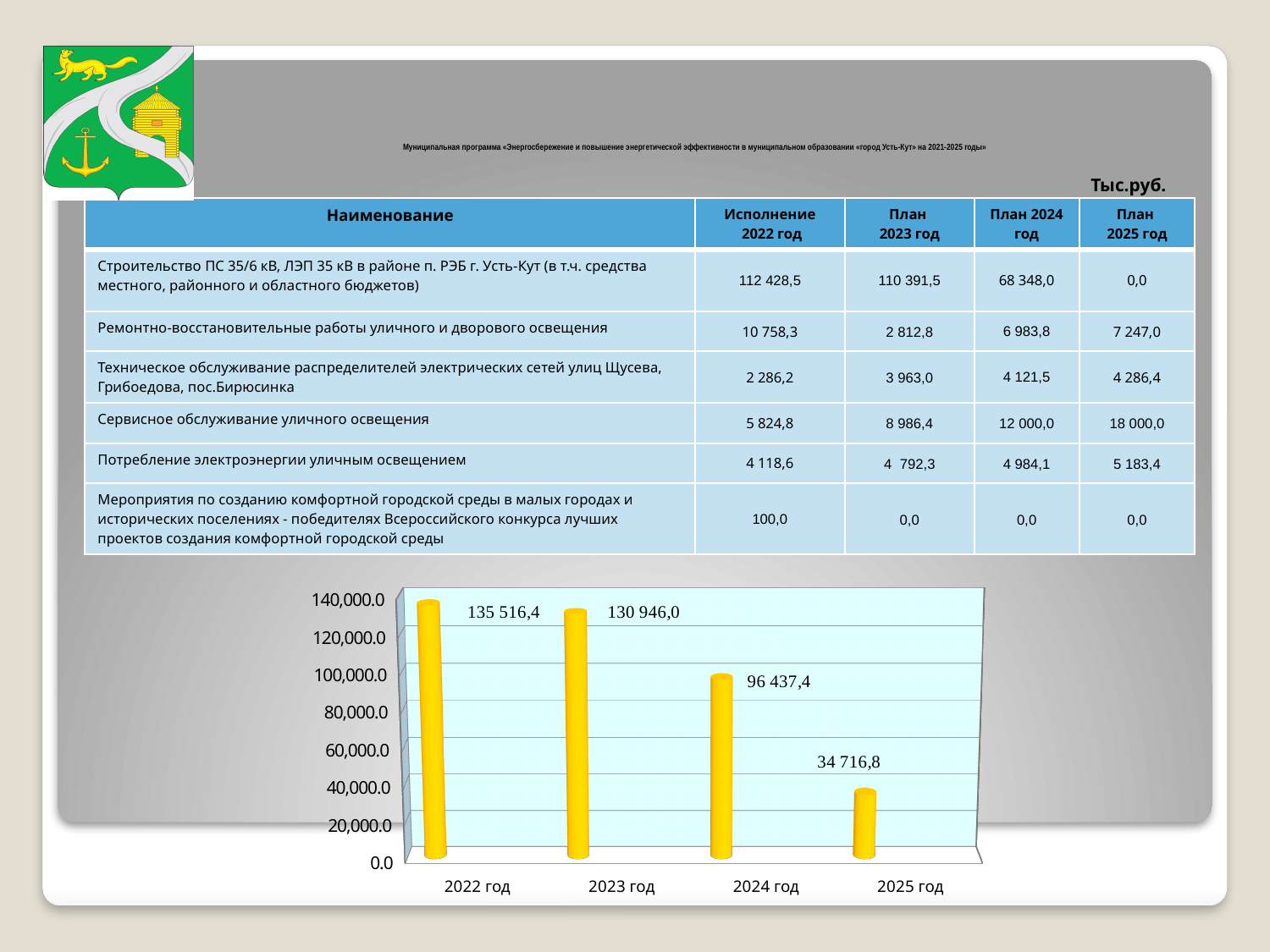
Is the value for 2025 год in the chart greater or less than 40,000.0? less What is the difference between the values for 2022 год and 2023 год in the chart? 4 570,4 What is the value shown for 2025 год in the chart? 34 716,8 Which year has the lowest value in the chart? 2025 год What is the value shown for 2023 год in the chart? 130 946,0 What is the difference between the values for 2024 год and 2025 год in the chart? 61 720,6 Which year has the highest value in the chart? 2022 год Which is larger in the chart, the value for 2023 год or the value for 2024 год? 2023 год How many years are plotted in the chart? 4 What is the value shown for 2022 год in the chart? 135 516,4 What is the value shown for 2024 год in the chart? 96 437,4 What kind of chart is shown on the slide? bar chart